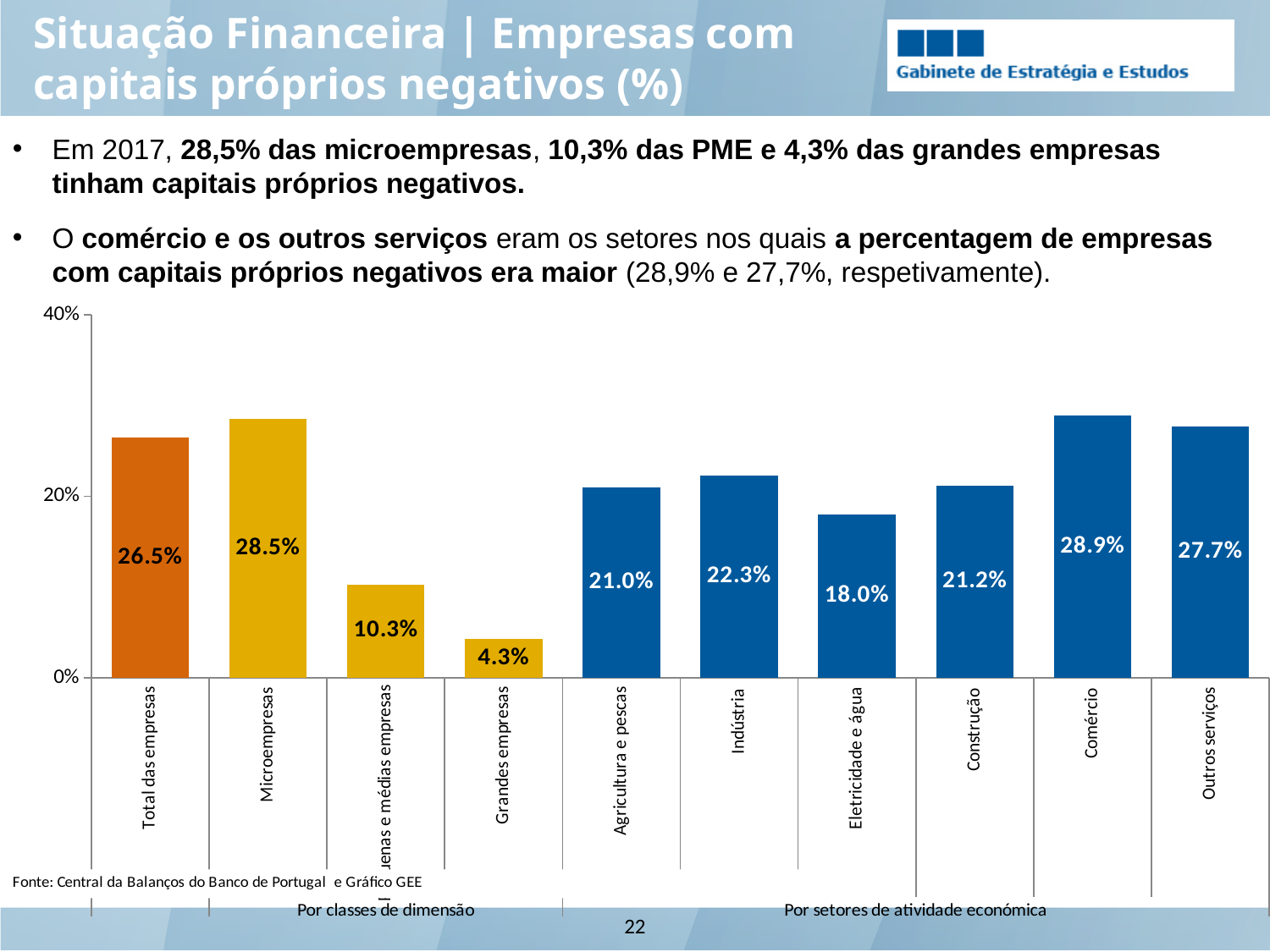
Which category has the lowest value? Grandes empresas What is the difference between the values for Microempresas and Grandes empresas? 24.2% Is the value for Agricultura e pescas greater or less than 20%? greater What is the difference between the values for Comércio and Outros serviços? 1.2% Which category has the highest value? Comércio How many bars are shown in the chart? 10 What is the value for Microempresas? 28.5% Which is larger, the value for Indústria or the value for Construção? Indústria What is the value for Grandes empresas? 4.3% What is the value for Comércio? 28.9% What is the value for Eletricidade e água? 18.0% What kind of chart is shown on the slide? Bar chart